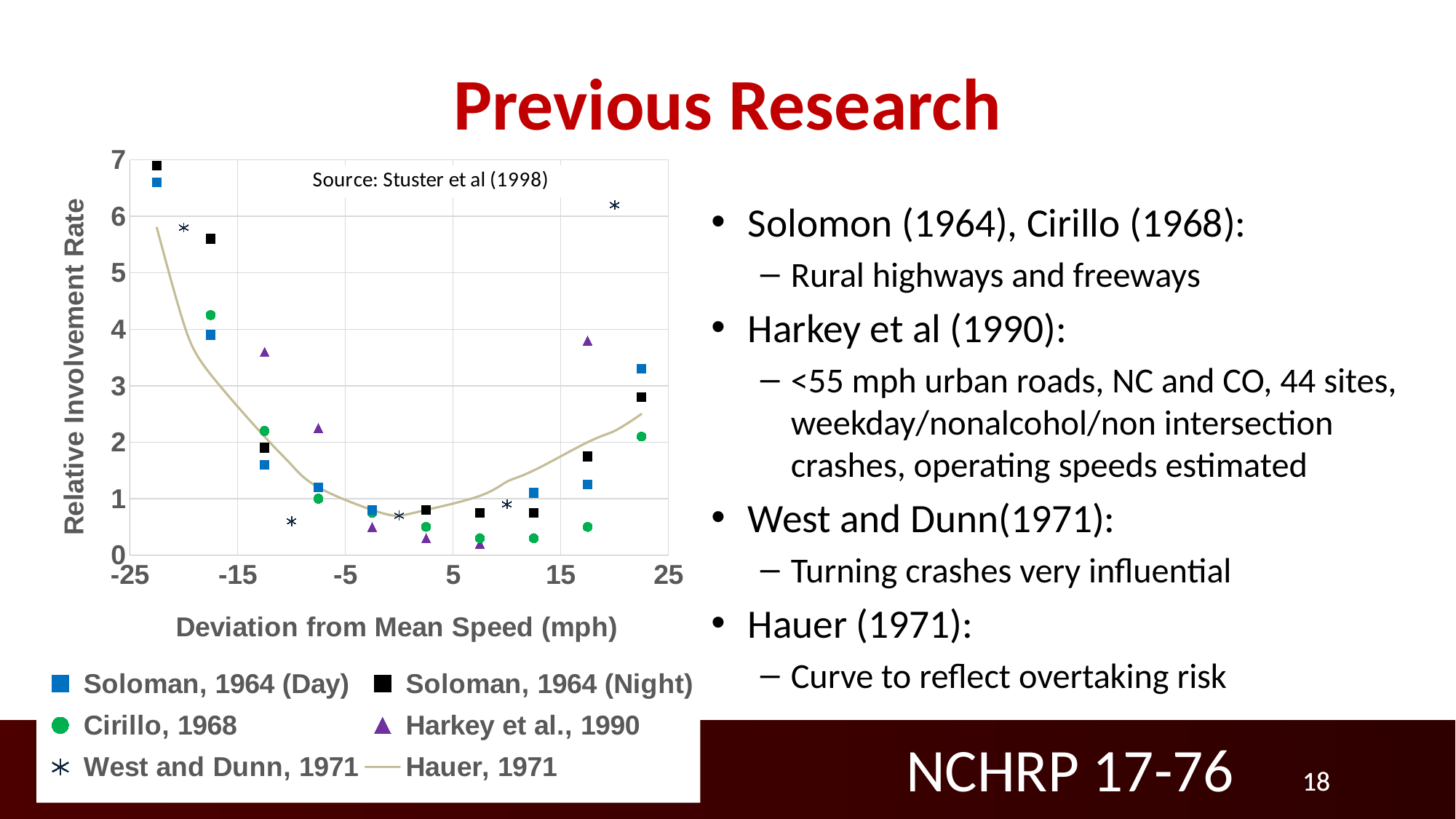
What is the title of the y axis of the chart? Relative Involvement Rate Does the Hauer, 1971 curve rise or fall as the deviation from mean speed goes from 0 to 25 mph? rise Is the Harkey et al., 1990 value at about 17 mph deviation greater or less than 3? greater Is the Cirillo, 1968 value at about 7 mph deviation greater or less than 1? less What kind of chart is shown on the slide? scatter chart Is the Cirillo, 1968 value at about -17 mph deviation greater or less than 4? greater Does the Hauer, 1971 curve rise or fall as the deviation from mean speed goes from -25 to 0 mph? fall What is the title of the x axis of the chart? Deviation from Mean Speed (mph) Which series is plotted as a line rather than as markers? Hauer, 1971 How many series does the chart legend list? 6